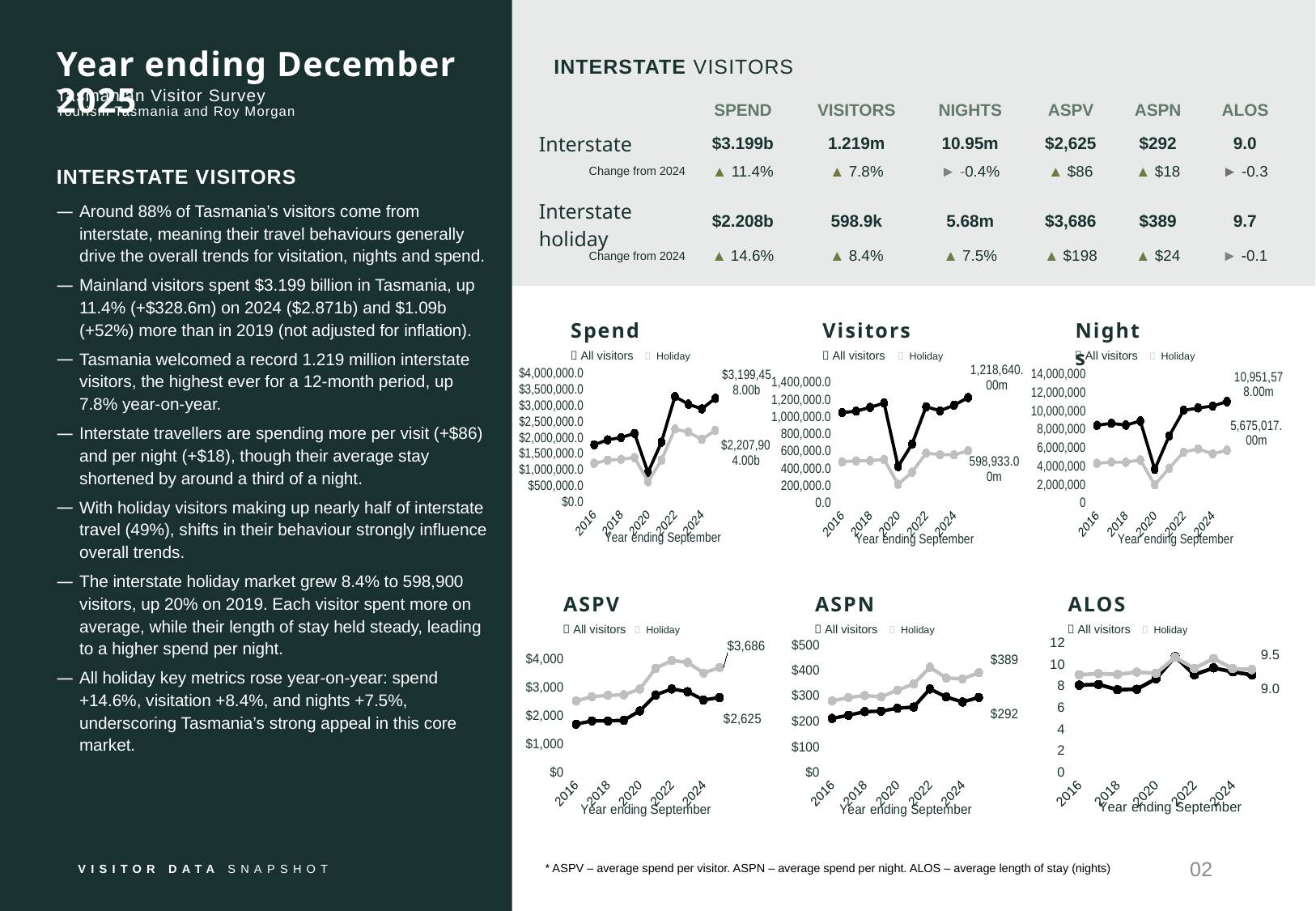
On the ASPN chart, what is the labelled final value for the All visitors series? $292 What is the x-axis title shown under the Visitors chart? Year ending September On the ASPV chart, what is the labelled final value for the Holiday series? $3,686 On the Spend chart, how many series does the legend list? 2 On the ALOS chart, what is the difference between the labelled final values for Holiday (9.5) and All visitors (9.0)? 0.5 On the ASPN chart, what is the difference between the labelled final values for Holiday ($389) and All visitors ($292)? $97 On the Spend chart, what kind of chart is it? line chart On the ASPV chart, which series has the higher value at the end of the period, All visitors or Holiday? Holiday On the Nights chart, is the All visitors value in 2020 greater or less than 8,000,000? less On the ALOS chart, what is the labelled final value for the Holiday series? 9.5 On the Spend chart, is the All visitors value in 2020 greater or less than $1,500,000.0? less